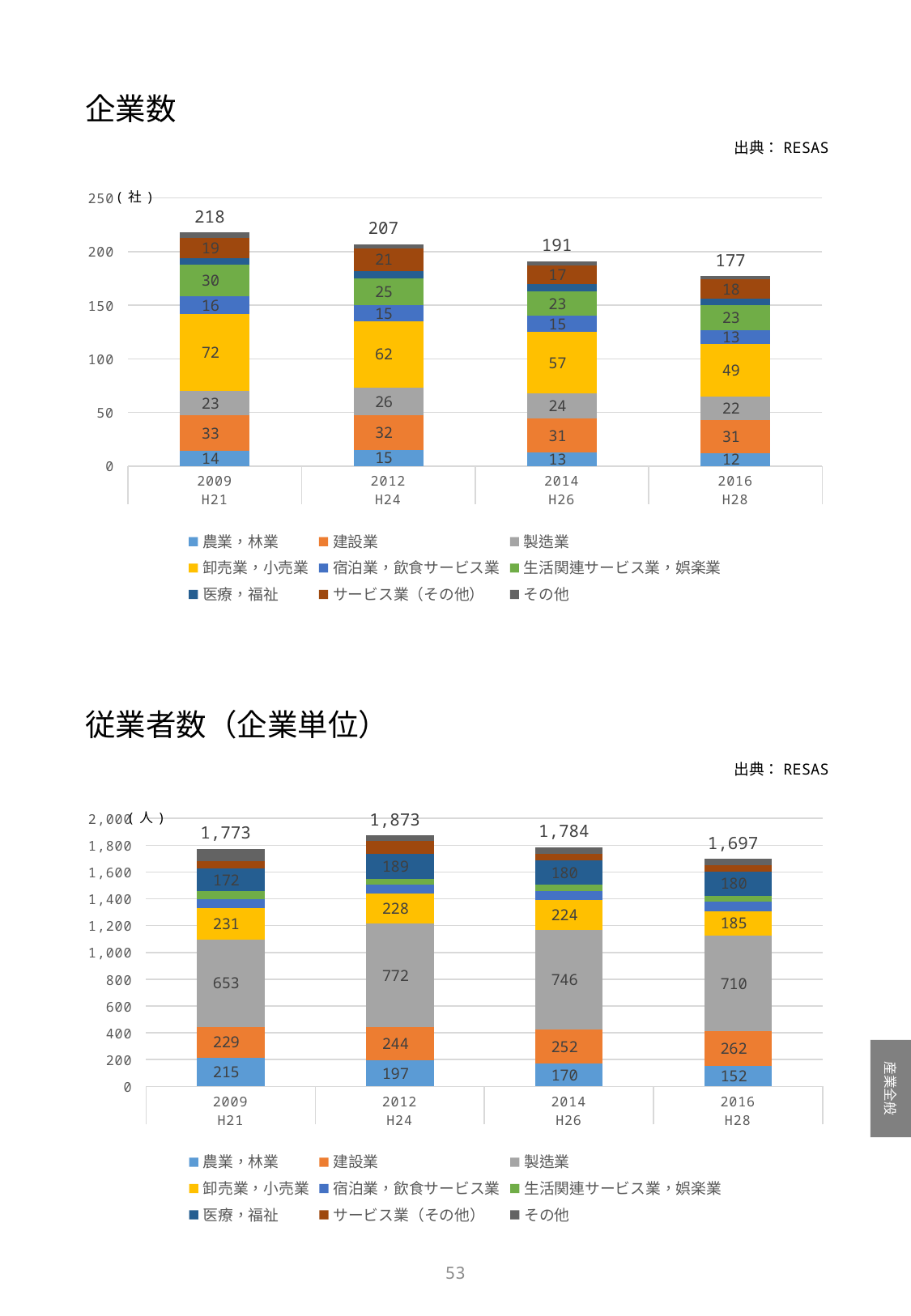
In the 企業数 chart, what is the difference between the 卸売業，小売業 values in 2009 (H21) and 2016 (H28)? 23 In the 従業者数（企業単位） chart, which is larger, the 建設業 value in 2009 (H21) or in 2016 (H28)? 2016 (H28) In the 企業数 chart, what is the total number of companies in 2009 (H21)? 218 In the 企業数 chart, which year has the lowest total number of companies? 2016 (H28) In the 従業者数（企業単位） chart, what is the total for 2012 (H24)? 1,873 In the 従業者数（企業単位） chart, what is the value for 製造業 in 2014 (H26)? 746 In the 従業者数（企業単位） chart, how many years are shown on the x axis? 4 In the 企業数 chart, what is the value for 卸売業，小売業 in 2012 (H24)? 62 What kind of chart is the 企業数 chart? stacked bar chart In the 企業数 chart, do the total values rise or fall from 2009 to 2016? fall In the 企業数 chart, how many series does the legend list? 9 In the 従業者数（企業単位） chart, which year has the highest total? 2012 (H24)